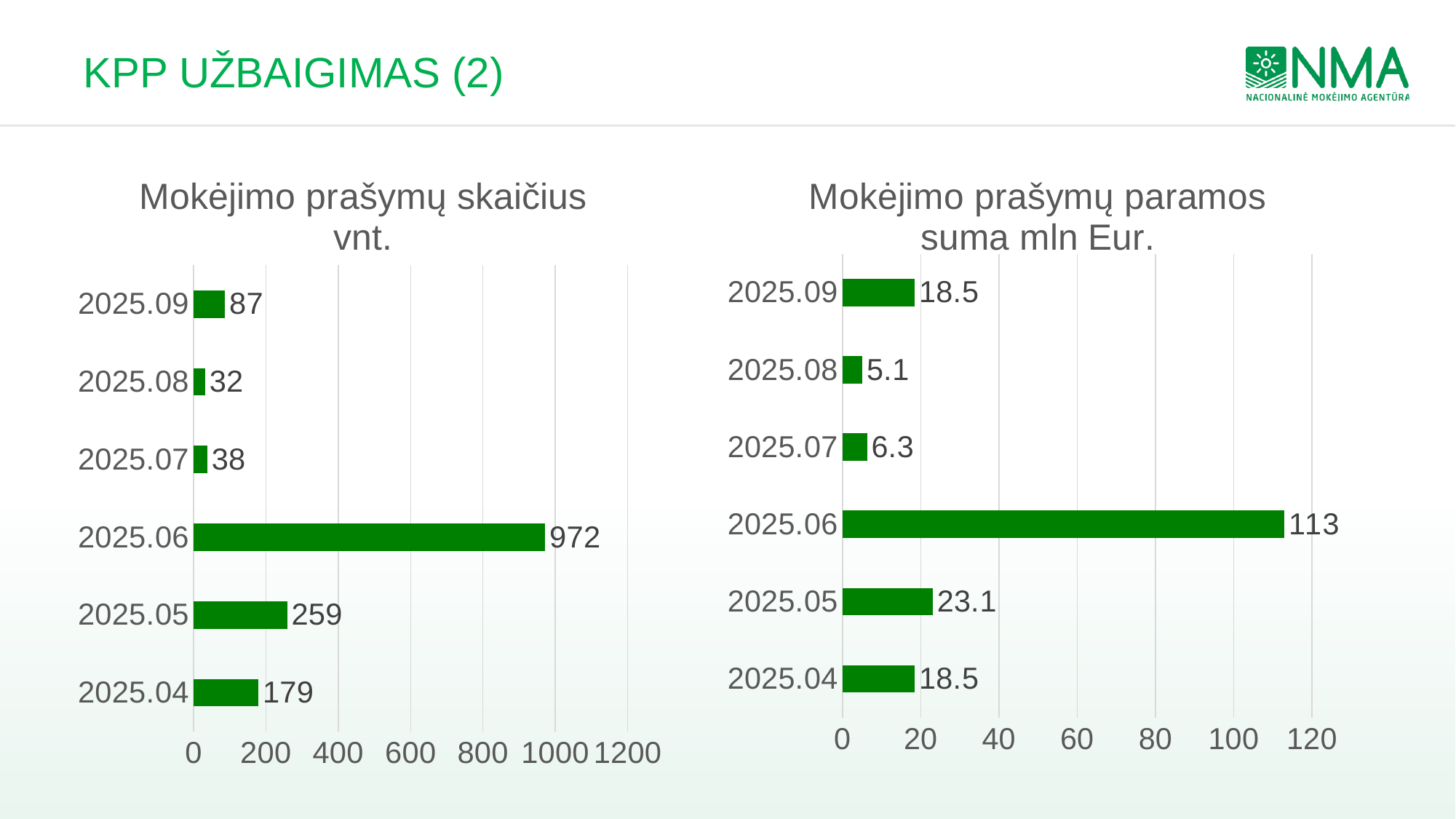
In the right chart 'Mokėjimo prašymų paramos suma mln Eur.', which month has the lowest value? 2025.08 What type of chart is the left chart 'Mokėjimo prašymų skaičius vnt.'? Bar chart In the right chart 'Mokėjimo prašymų paramos suma mln Eur.', what is the difference between the values for 2025.05 and 2025.09? 4.6 In the left chart 'Mokėjimo prašymų skaičius vnt.', which is larger, the value for 2025.09 or 2025.07? 2025.09 In the left chart 'Mokėjimo prašymų skaičius vnt.', which month has the highest value? 2025.06 In the left chart 'Mokėjimo prašymų skaičius vnt.', what is the difference between the values for 2025.06 and 2025.05? 713 In the left chart 'Mokėjimo prašymų skaičius vnt.', what is the value for 2025.06? 972 In the right chart 'Mokėjimo prašymų paramos suma mln Eur.', what is the value for 2025.05? 23.1 In the right chart 'Mokėjimo prašymų paramos suma mln Eur.', what is the value for 2025.08? 5.1 In the left chart 'Mokėjimo prašymų skaičius vnt.', what is the value for 2025.04? 179 How many months are shown in the right chart 'Mokėjimo prašymų paramos suma mln Eur.'? 6 In the left chart 'Mokėjimo prašymų skaičius vnt.', which month has the lowest value? 2025.08